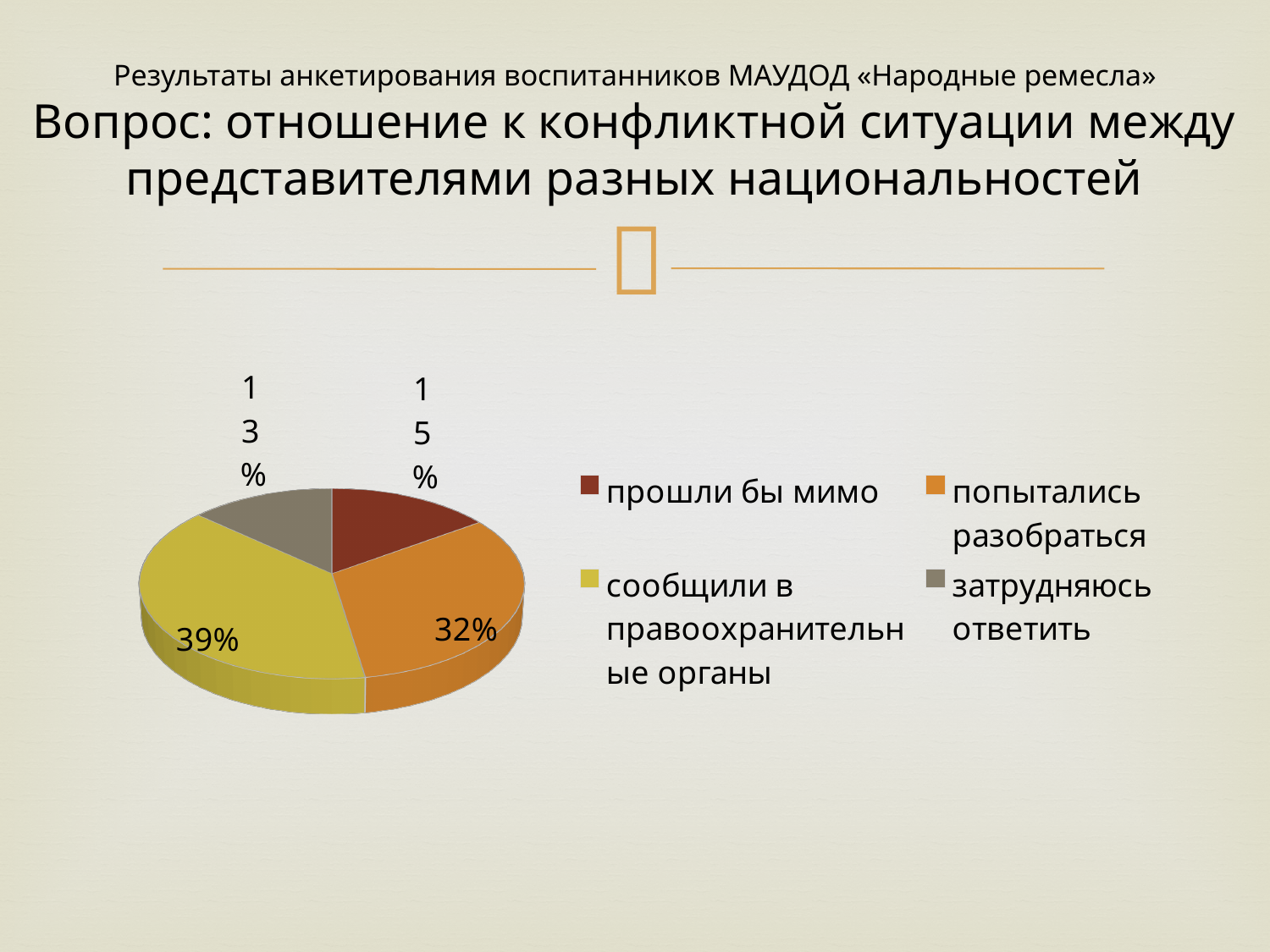
What is the difference in percentage points between «сообщили в правоохранительные органы» and «попытались разобраться»? 7 Which answer option has the largest share of the pie? сообщили в правоохранительные органы What share of respondents chose «сообщили в правоохранительные органы»? 39% What kind of chart is shown on the slide? pie chart Which is larger: the share for «прошли бы мимо» or the share for «затрудняюсь ответить»? прошли бы мимо How many slices does the pie chart have? 4 What share of respondents chose «попытались разобраться»? 32% What colour is the slice for «попытались разобраться»? orange How many entries does the legend list? 4 What share of respondents chose «прошли бы мимо»? 15% What share of respondents chose «затрудняюсь ответить»? 13% Which answer option has the smallest share of the pie? затрудняюсь ответить